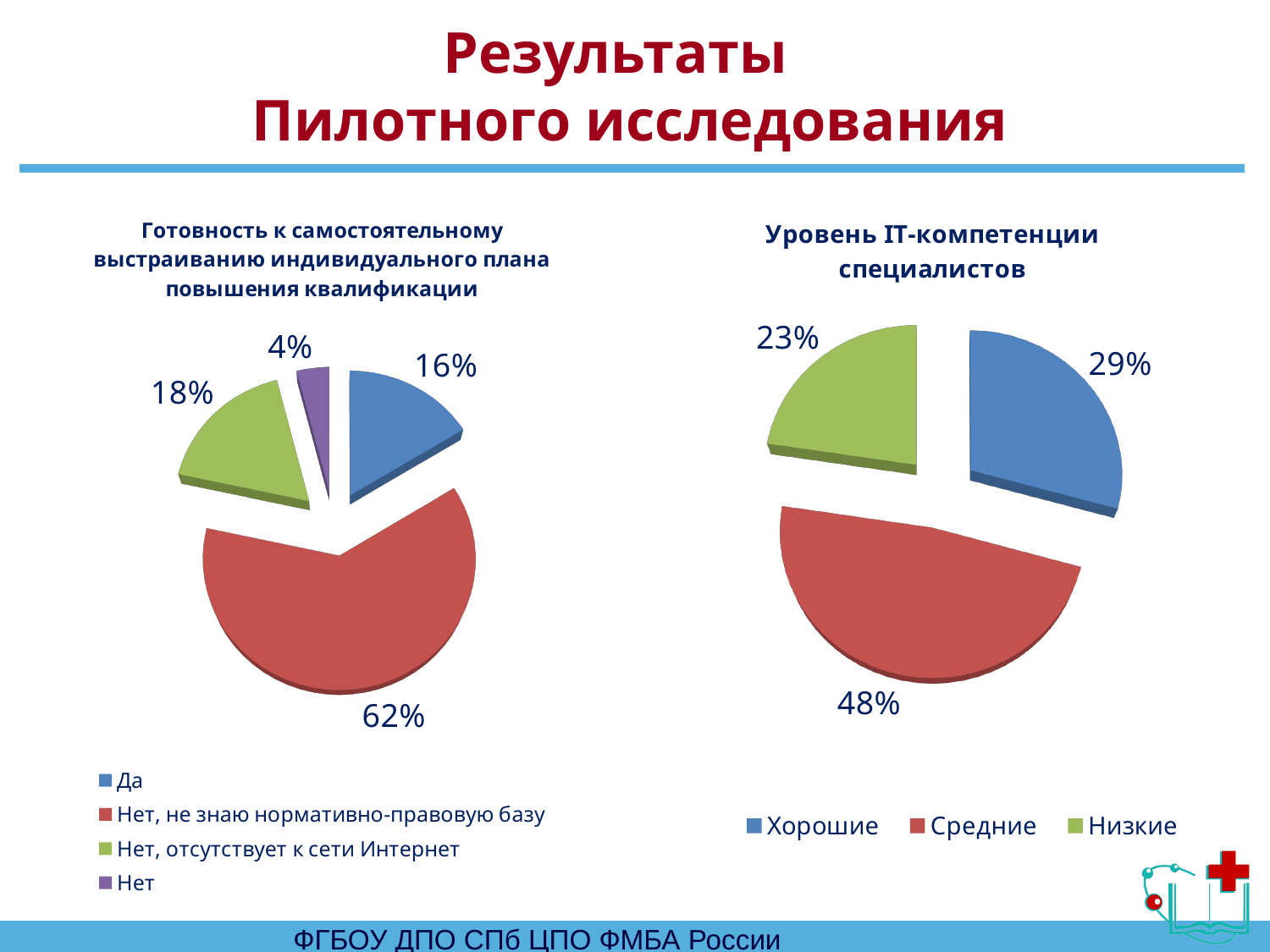
In the right chart, what share is shown for "Хорошие"? 29% In the left chart, what is the difference between the shares for "Нет, не знаю нормативно-правовую базу" and "Да"? 46% In the right chart, which category has the smallest share? Низкие In the right chart, which is larger: the share for "Хорошие" or for "Низкие"? Хорошие In the left chart, which category has the largest slice? Нет, не знаю нормативно-правовую базу In the left chart, which category has the smallest slice? Нет What type of chart is used for "Уровень IT-компетенции специалистов"? Pie chart In the chart titled "Уровень IT-компетенции специалистов", what share is shown for "Средние"? 48% In the left chart, how many categories does the legend list? 4 In the left chart, what share is shown for "Нет, не знаю нормативно-правовую базу"? 62% In the chart titled "Готовность к самостоятельному выстраиванию индивидуального плана повышения квалификации", what share is labelled for "Да"? 16% In the left chart, what share is shown for "Нет, отсутствует к сети Интернет"? 18%